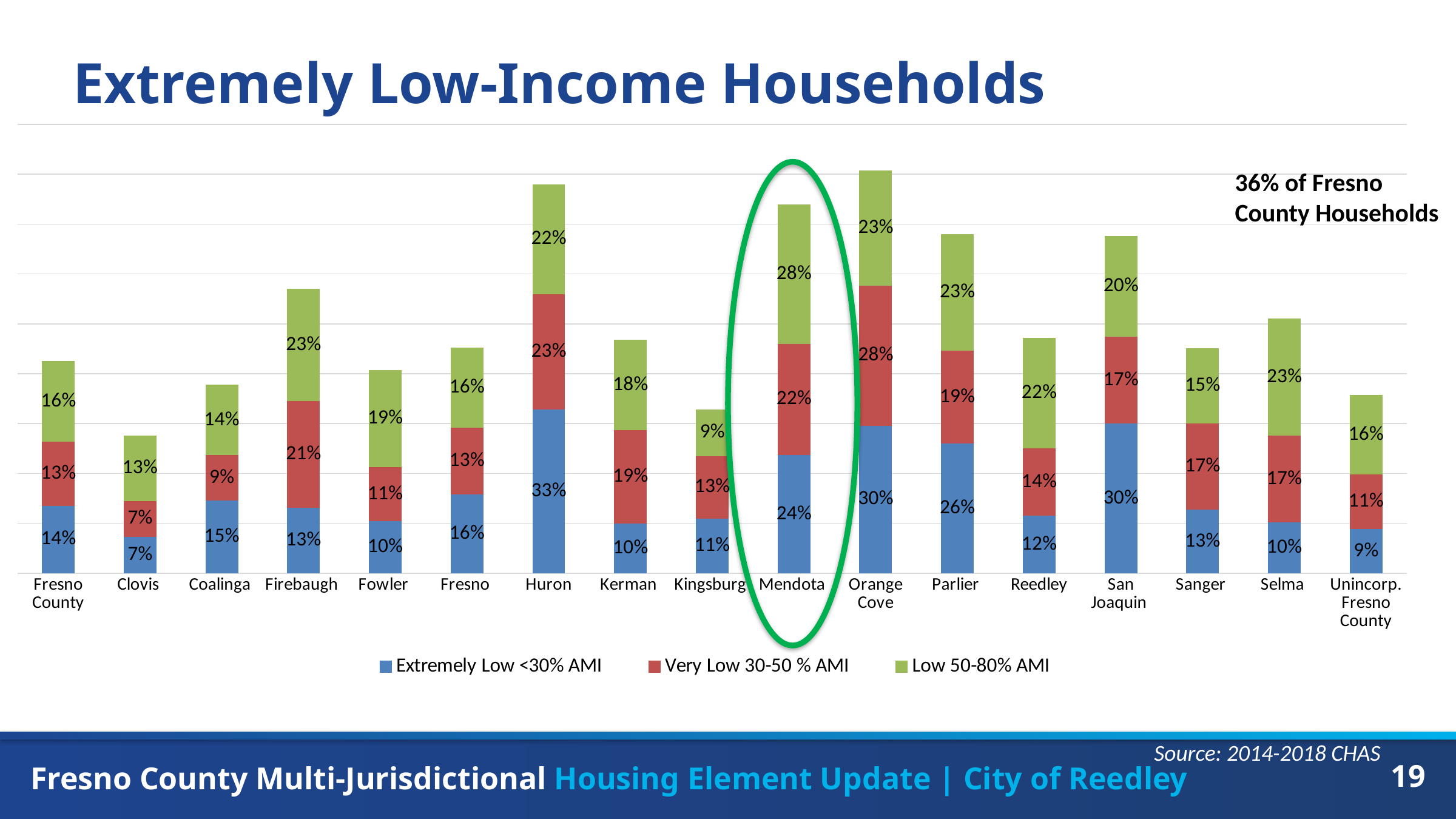
What is the Extremely Low <30% AMI value for Huron? 33% Which jurisdiction has the highest Extremely Low <30% AMI share? Huron Which jurisdiction has the lowest Extremely Low <30% AMI share? Clovis Which jurisdiction has the lowest Low 50-80% AMI share? Kingsburg How many series does the legend list? 3 Which is larger, the Very Low 30-50 % AMI value for Firebaugh or for Kerman? Firebaugh How many jurisdictions are shown on the x axis? 17 What is the Low 50-80% AMI value for Mendota? 28% What is the total of the stacked bar for Clovis? 27% What is the difference between the Extremely Low <30% AMI values for Orange Cove and Reedley? 18% What is the total of the stacked bar for Mendota? 74% What is the Very Low 30-50 % AMI value for Orange Cove? 28%